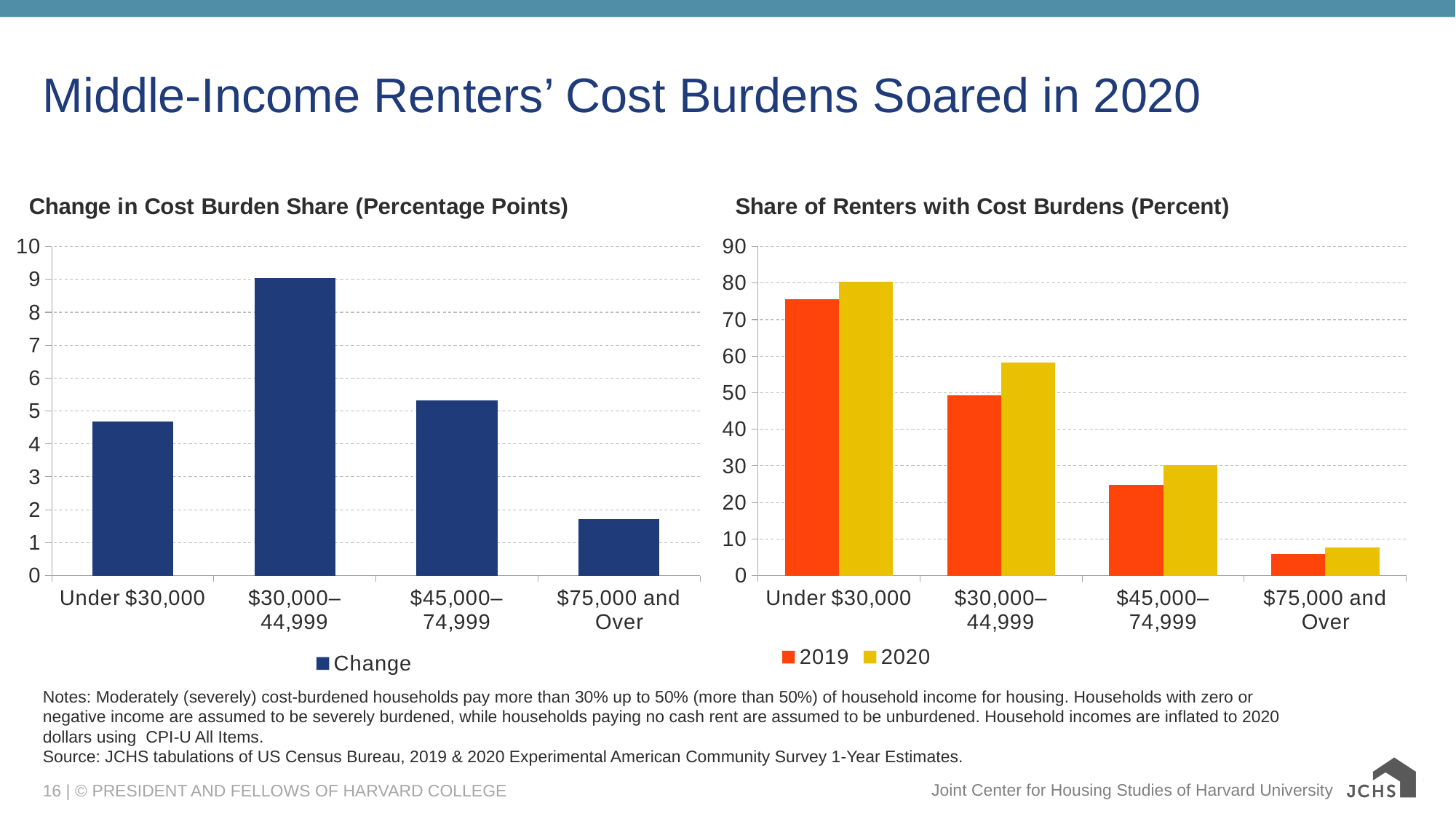
In the chart titled "Change in Cost Burden Share (Percentage Points)", is the value for $75,000 and Over greater or less than 2? less How many income groups are shown in the chart titled "Change in Cost Burden Share (Percentage Points)"? 4 In the chart titled "Change in Cost Burden Share (Percentage Points)", which income group has the highest value? $30,000–44,999 How many series does the legend list in the chart titled "Share of Renters with Cost Burdens (Percent)"? 2 In the chart titled "Share of Renters with Cost Burdens (Percent)", is the 2020 value for $30,000–44,999 greater or less than 50? greater In the chart titled "Change in Cost Burden Share (Percentage Points)", which income group has the lowest value? $75,000 and Over In the chart titled "Change in Cost Burden Share (Percentage Points)", is the value for $30,000–44,999 greater or less than 8? greater What type of chart is the chart titled "Share of Renters with Cost Burdens (Percent)"? bar chart In the chart titled "Share of Renters with Cost Burdens (Percent)", which income group has the highest 2020 value? Under $30,000 In the chart titled "Change in Cost Burden Share (Percentage Points)", which is larger: the value for Under $30,000 or the value for $45,000–74,999? $45,000–74,999 In the chart titled "Share of Renters with Cost Burdens (Percent)", do the 2019 values rise or fall as income increases along the x axis? fall